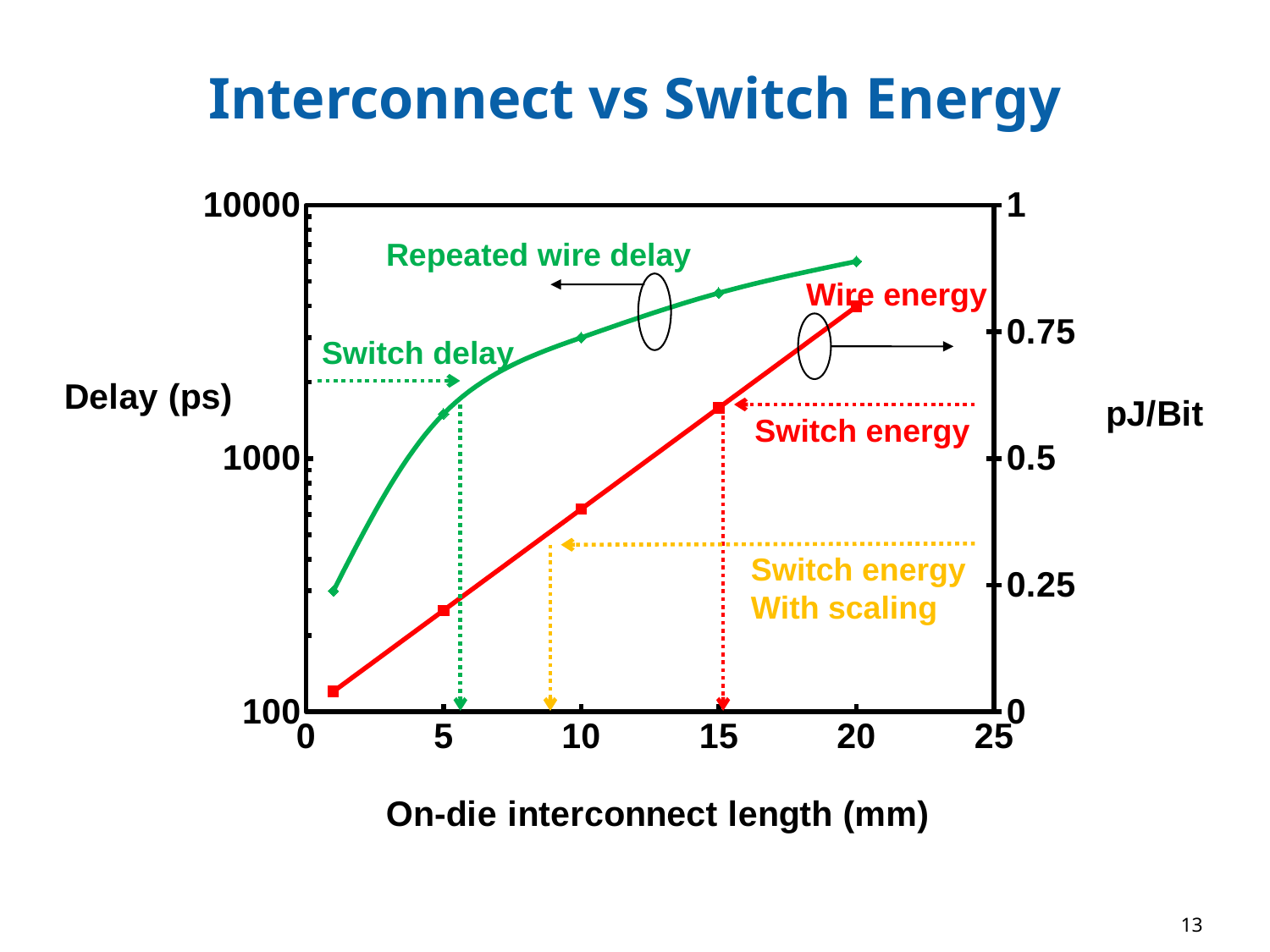
Is the Wire energy larger at 15 mm or at 5 mm? 15 mm Does the Repeated wire delay rise or fall as the interconnect length increases? rise How many data points are plotted on the Wire energy line? 5 Does the Wire energy rise or fall as the interconnect length increases? rise Is the Repeated wire delay at 1 mm greater or less than 1000 ps? less What is the title of the chart on the slide? Interconnect vs Switch Energy Is the Wire energy at 5 mm greater or less than 0.25 pJ/Bit? less Is the Wire energy at 15 mm greater or less than 0.5 pJ/Bit? greater What kind of chart is shown on the slide? line chart At which interconnect length is the Wire energy highest? 20 mm What is the label of the x axis? On-die interconnect length (mm)